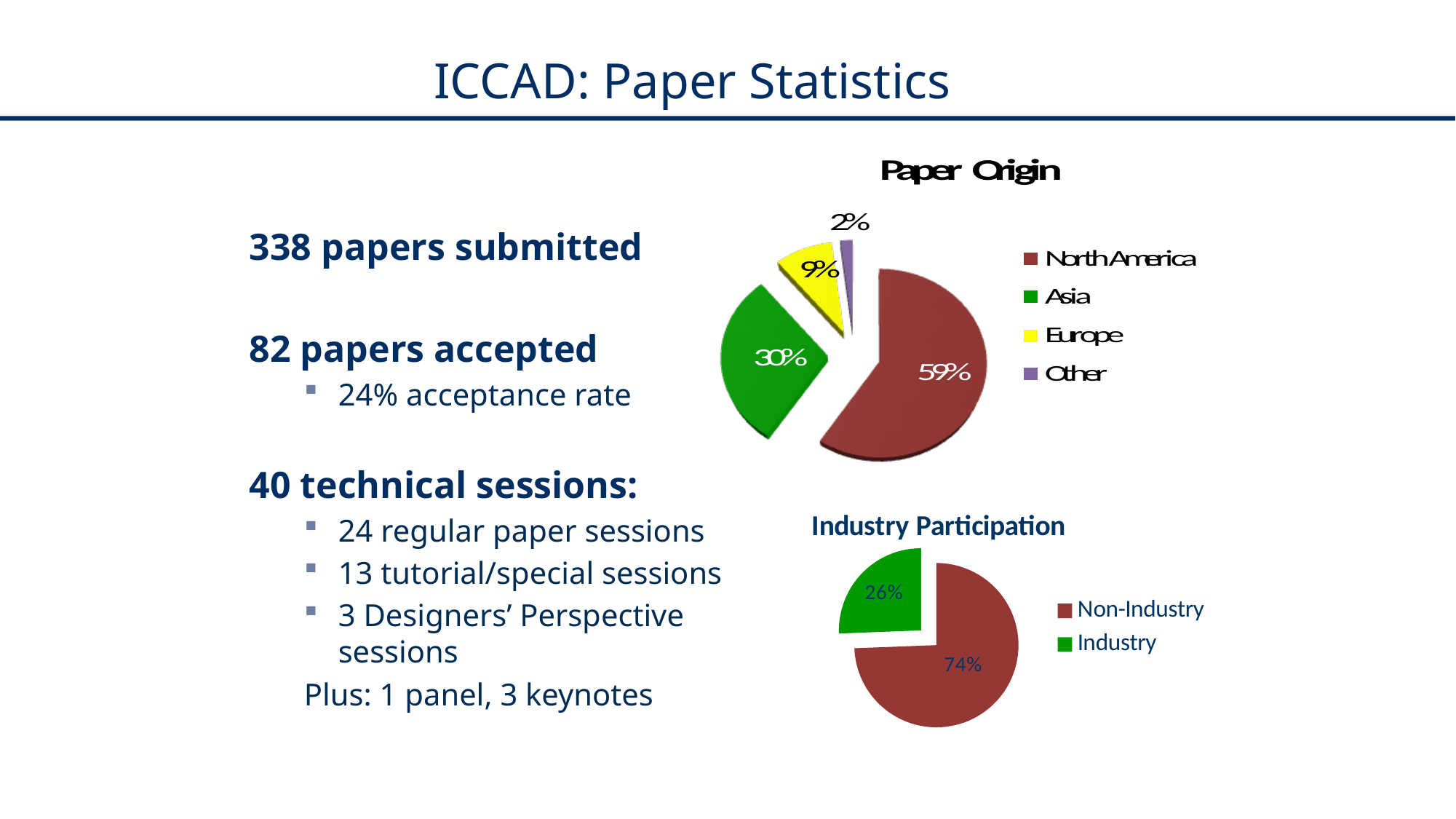
In the Paper Origin chart, which region has the largest share? North America What kind of chart is the Paper Origin chart? Pie chart In the Paper Origin chart, what share of papers comes from Other? 2% In the Paper Origin chart, what share of papers comes from North America? 59% In the Paper Origin chart, which region has the smallest share? Other In the Industry Participation chart, what share is Industry? 26% In the Paper Origin chart, what is the difference in percentage points between North America and Asia? 29 In the Paper Origin chart, what share of papers comes from Europe? 9% In the Industry Participation chart, what share is Non-Industry? 74% In the Paper Origin chart, how many regions are shown in the legend? 4 In the Industry Participation chart, which colour represents Industry? Green In the Paper Origin chart, what share of papers comes from Asia? 30%